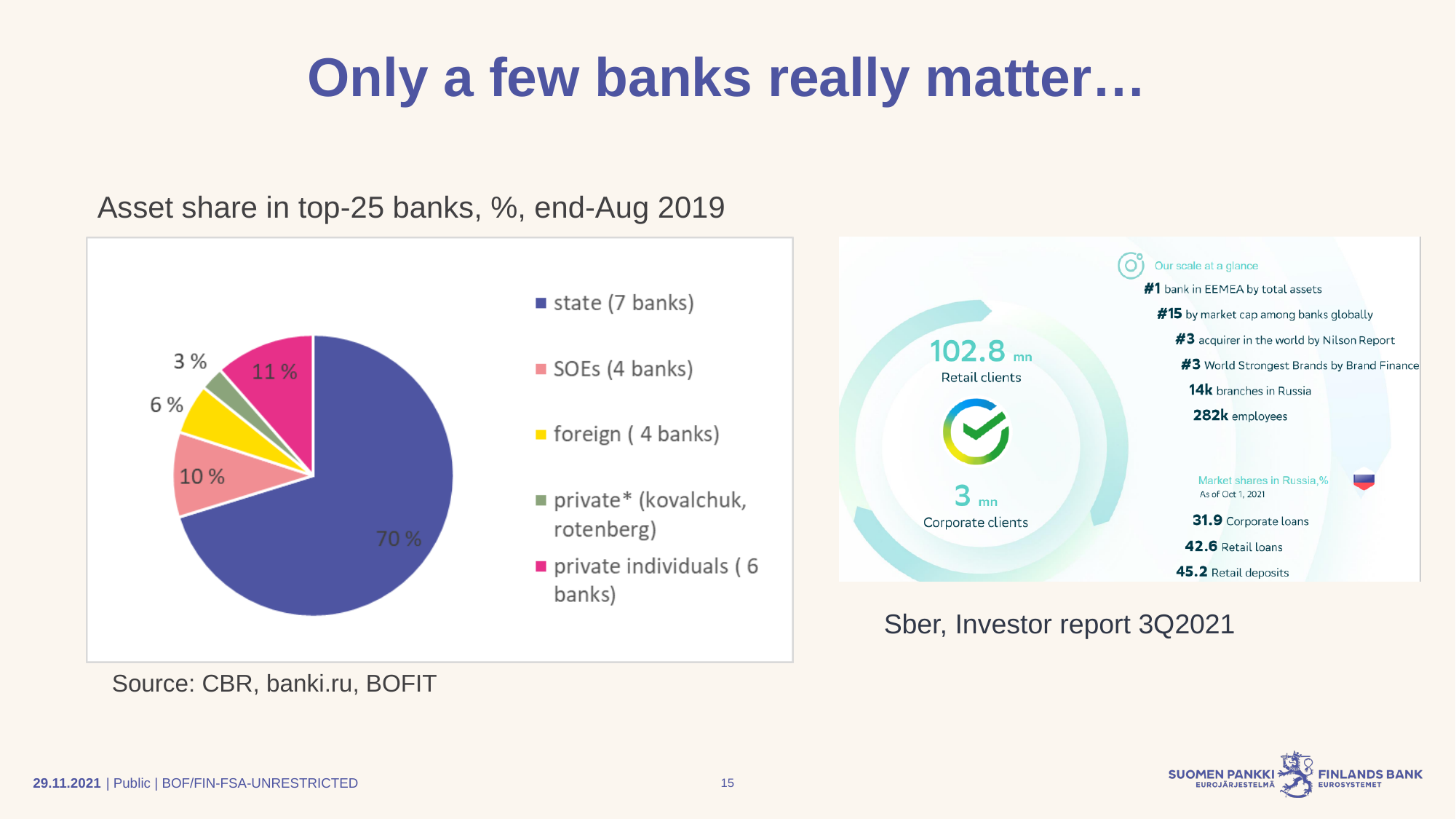
What kind of chart is 'Asset share in top-25 banks, %, end-Aug 2019'? pie chart In the pie chart 'Asset share in top-25 banks, %, end-Aug 2019', which category has the largest share? state (7 banks) In the pie chart 'Asset share in top-25 banks, %, end-Aug 2019', what is the share for private* (kovalchuk, rotenberg)? 3 % In the pie chart 'Asset share in top-25 banks, %, end-Aug 2019', what is the difference between the shares of state (7 banks) and SOEs (4 banks)? 60 % In the pie chart 'Asset share in top-25 banks, %, end-Aug 2019', what is the share for foreign (4 banks)? 6 % In the pie chart 'Asset share in top-25 banks, %, end-Aug 2019', which is larger: the share of private individuals (6 banks) or the share of SOEs (4 banks)? private individuals (6 banks) In the pie chart 'Asset share in top-25 banks, %, end-Aug 2019', what is the share for SOEs (4 banks)? 10 % In the pie chart 'Asset share in top-25 banks, %, end-Aug 2019', what is the share for private individuals (6 banks)? 11 % In the pie chart 'Asset share in top-25 banks, %, end-Aug 2019', which category has the smallest share? private* (kovalchuk, rotenberg) In the pie chart 'Asset share in top-25 banks, %, end-Aug 2019', what is the share for state (7 banks)? 70 % In the pie chart 'Asset share in top-25 banks, %, end-Aug 2019', what colour is the slice for foreign (4 banks)? yellow How many slices does the pie chart 'Asset share in top-25 banks, %, end-Aug 2019' have? 5